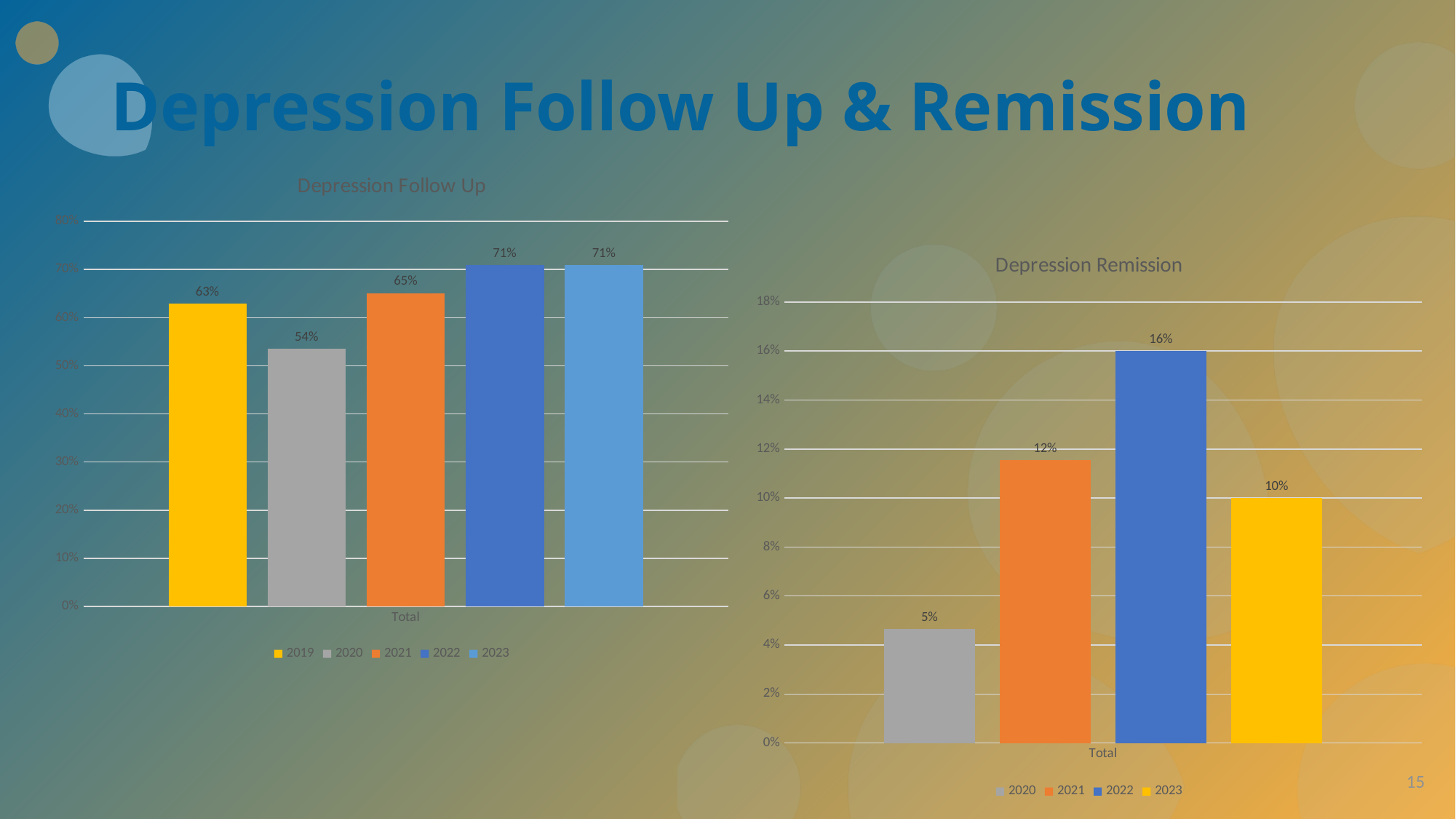
In the Depression Remission chart, which year has the highest value? 2022 In the Depression Follow Up chart, what is the value for 2020? 54% In the Depression Follow Up chart, what is the difference between the 2021 and 2020 values? 11% What kind of chart is the Depression Remission chart? Bar chart In the Depression Remission chart, what is the value for 2021? 12% In the Depression Remission chart, is the value for 2022 larger or the value for 2021? 2022 In the Depression Remission chart, which year has the lowest value? 2020 In the Depression Remission chart, what is the difference between the 2022 and 2023 values? 6% In the Depression Remission chart, how many series does the legend list? 4 In the Depression Follow Up chart, how many series does the legend list? 5 In the Depression Follow Up chart, which year has the lowest value? 2020 In the Depression Follow Up chart, what is the value for 2019? 63%